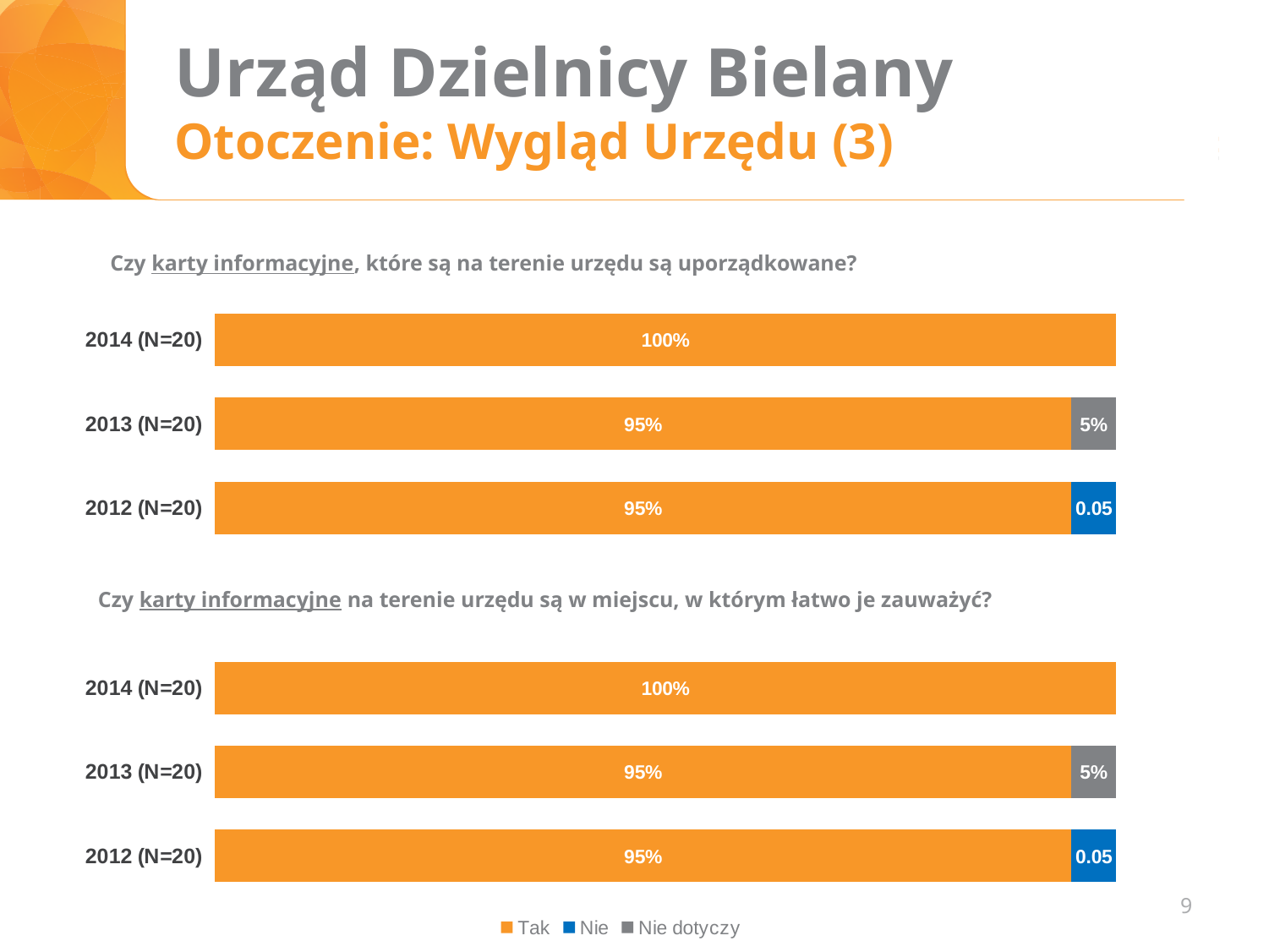
In the top chart (Czy karty informacyjne, które są na terenie urzędu są uporządkowane?), what is the value for Tak in 2014 (N=20)? 100% In the top chart (Czy karty informacyjne, które są na terenie urzędu są uporządkowane?), what is the value for Nie dotyczy in 2013 (N=20)? 5% What type of chart is the bottom chart (Czy karty informacyjne na terenie urzędu są w miejscu, w którym łatwo je zauważyć?)? Stacked bar chart How many series does the legend at the bottom of the slide list? 3 In the bottom chart (Czy karty informacyjne na terenie urzędu są w miejscu, w którym łatwo je zauważyć?), what is the value for Tak in 2012 (N=20)? 95% In the bottom chart (Czy karty informacyjne na terenie urzędu są w miejscu, w którym łatwo je zauważyć?), which year has the highest value for Tak? 2014 (N=20) In the bottom chart (Czy karty informacyjne na terenie urzędu są w miejscu, w którym łatwo je zauważyć?), what is the value for Nie dotyczy in 2013 (N=20)? 5% In the top chart (Czy karty informacyjne, które są na terenie urzędu są uporządkowane?), what is the value for Nie in 2012 (N=20)? 0.05 How many categories (years) does the top chart (Czy karty informacyjne, które są na terenie urzędu są uporządkowane?) show? 3 In the top chart (Czy karty informacyjne, które są na terenie urzędu są uporządkowane?), what is the difference between the Tak value in 2014 (N=20) and in 2013 (N=20)? 5% In the top chart (Czy karty informacyjne, które są na terenie urzędu są uporządkowane?), what is the value for Tak in 2013 (N=20)? 95% In the bottom chart (Czy karty informacyjne na terenie urzędu są w miejscu, w którym łatwo je zauważyć?), is the Tak value larger in 2014 (N=20) or in 2012 (N=20)? 2014 (N=20)